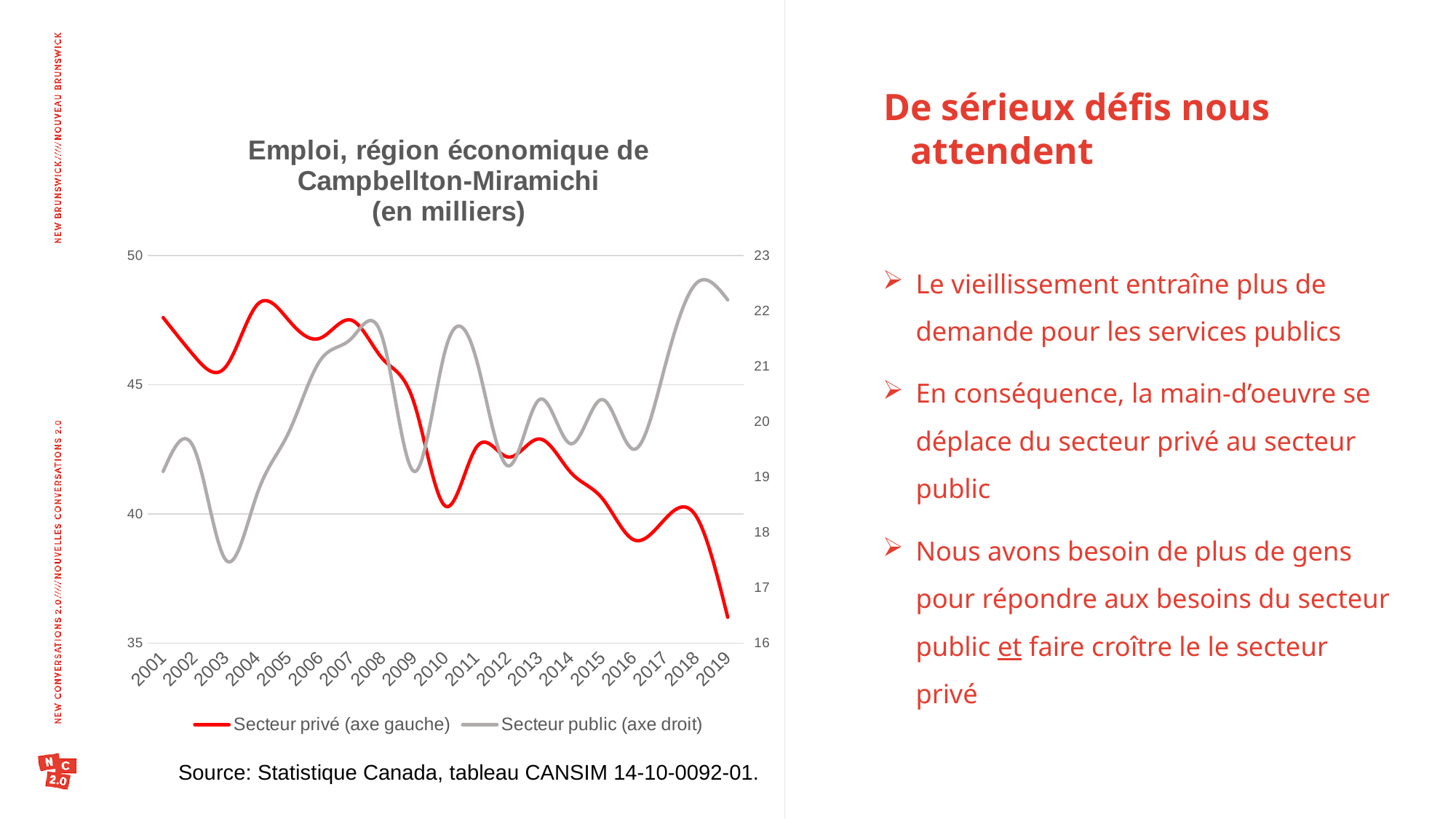
In which year is the Secteur privé line at its lowest? 2019 What kind of chart is shown on the slide? line chart Does the Secteur privé line rise or fall overall from 2001 to 2019? fall Which series is plotted against the right axis according to the legend? Secteur public (axe droit) Does the Secteur public line rise or fall overall from 2001 to 2019? rise Is the Secteur privé value for 2019 greater or less than 40? less How many years are plotted along the x axis? 19 Is the Secteur public value for 2003 greater or less than 18? less Is the Secteur privé value for 2004 greater or less than 45? greater In which year is the Secteur public line at its lowest? 2003 How many series does the legend list? 2 What is the title of the chart? Emploi, région économique de Campbellton-Miramichi (en milliers)